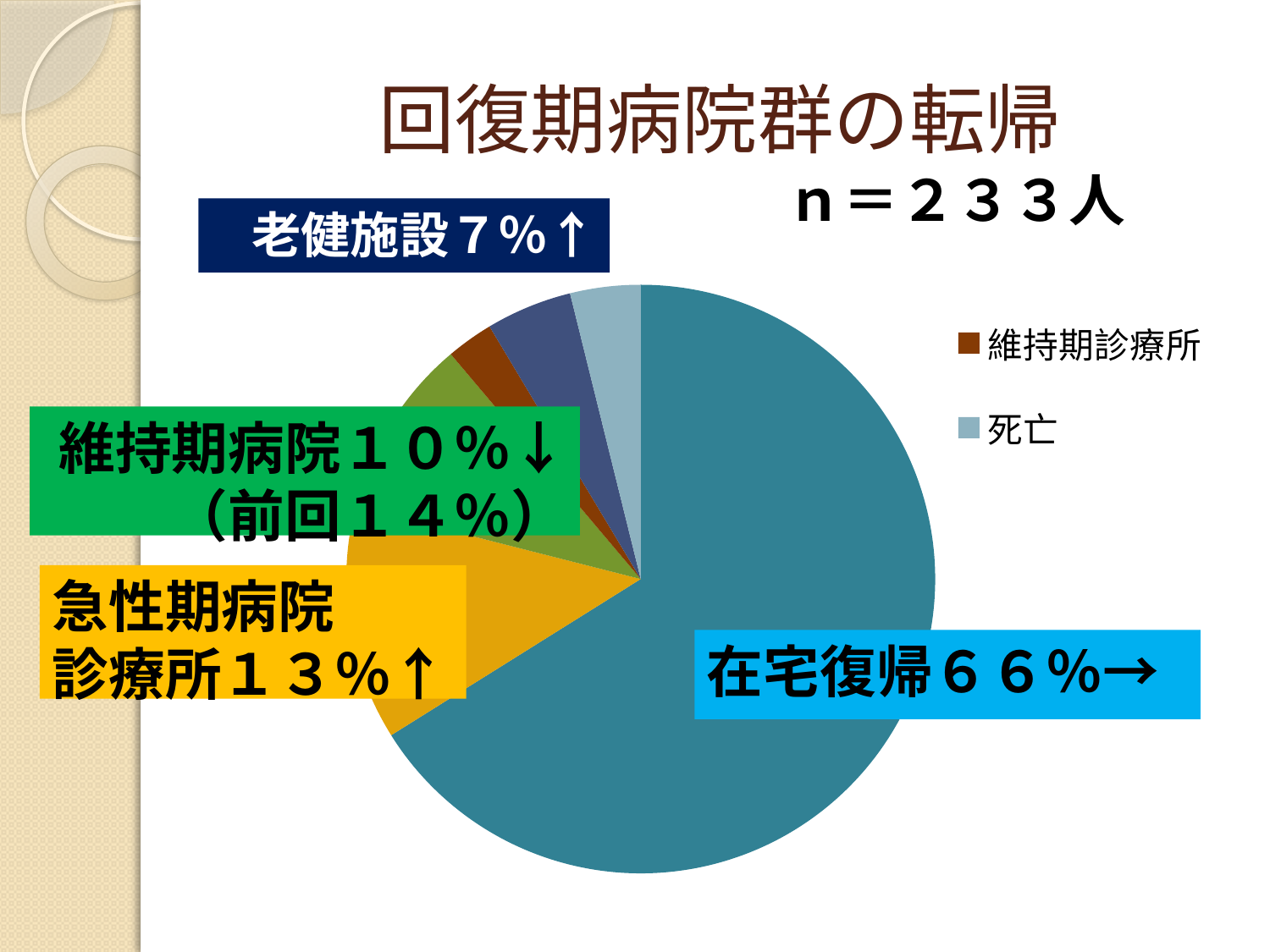
How many percentage points larger is 急性期病院診療所 than 維持期病院? 3 What percentage is shown for 維持期病院? 10% What kind of chart is shown on the slide? pie chart What percentage of the pie is 在宅復帰? 66% What was the previous (前回) percentage for 維持期病院? 14% How many percentage points larger is 在宅復帰 than 急性期病院診療所? 53 Which is larger, the share for 維持期病院 or the share for 老健施設? 維持期病院 Which category has the largest share of the pie? 在宅復帰 What is the title of the chart? 回復期病院群の転帰 What percentage is shown for 急性期病院診療所? 13% What percentage is shown for 老健施設? 7% What is the sample size (n) shown on the slide? 233人